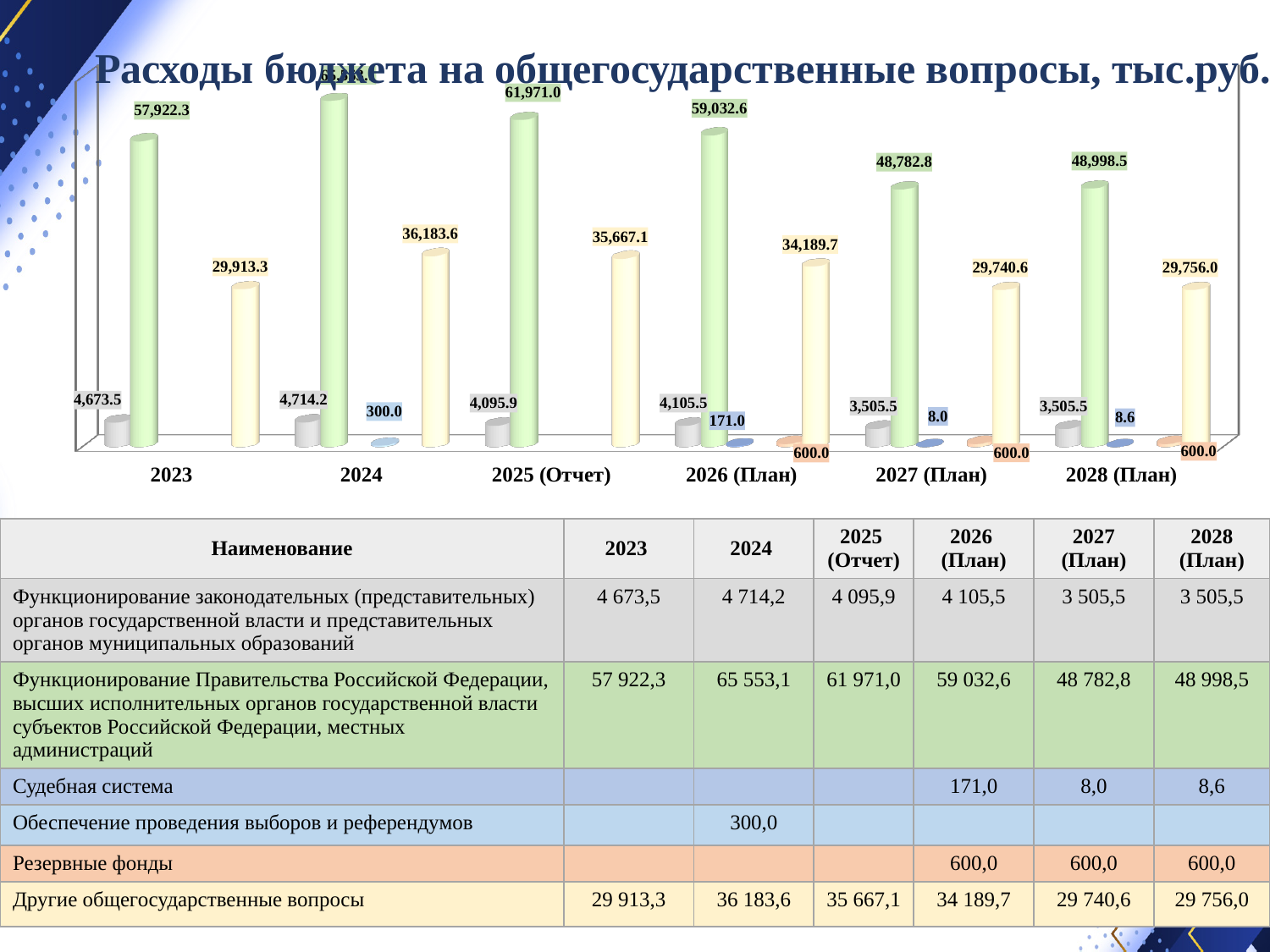
What type of chart is shown on the slide? bar chart What is the title of the chart? Расходы бюджета на общегосударственные вопросы, тыс.руб. What is the value of the tallest (green) bar for 2023? 57,922.3 What is the value of the gray bar for 2027 (План)? 3,505.5 How many year categories are shown on the x axis of the chart? 6 In which year does the green bar reach its lowest value? 2027 (План) Does the gray bar value rise or fall from 2023 to 2028 (План)? fall What is the value of the small blue bar for 2026 (План)? 171.0 In which year is the yellow bar highest? 2024 Which is larger: the green bar for 2025 (Отчет) or the green bar for 2026 (План)? 2025 (Отчет) What is the difference between the yellow bar values for 2024 and 2023? 6,270.3 What is the value of the yellow bar for 2025 (Отчет)? 35,667.1